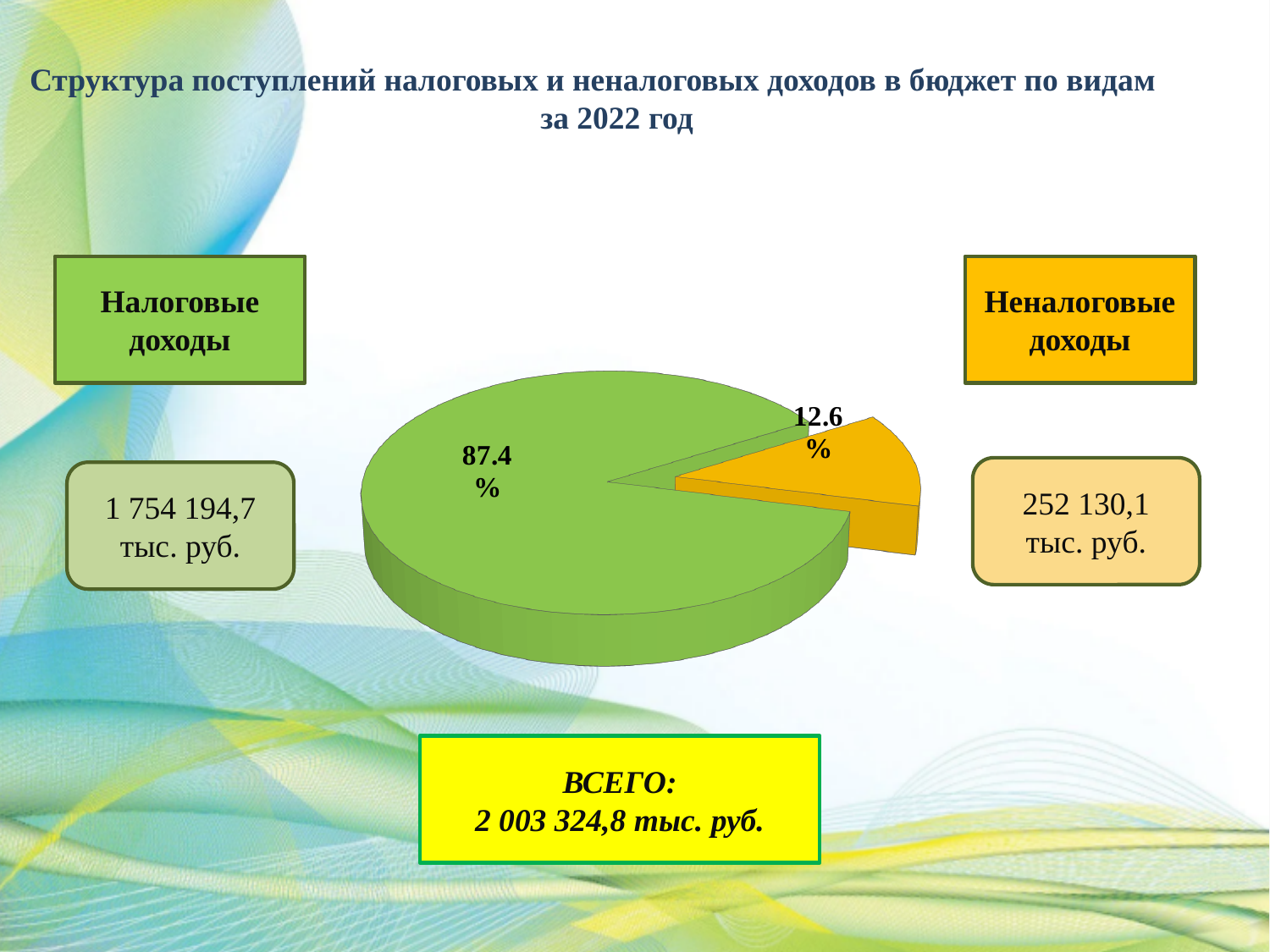
Which category has the largest slice of the pie? Налоговые доходы What is the difference in percentage points between the Налоговые доходы slice and the Неналоговые доходы slice? 74.8 Which category has the smallest slice of the pie? Неналоговые доходы How many slices does the pie chart have? 2 What colour is the slice for Неналоговые доходы? orange What is the amount shown for Неналоговые доходы? 252 130,1 тыс. руб. What is the total (ВСЕГО) shown on the slide? 2 003 324,8 тыс. руб. Which is larger, the share for Налоговые доходы or the share for Неналоговые доходы? Налоговые доходы What is the amount shown for Налоговые доходы? 1 754 194,7 тыс. руб. What kind of chart is shown on the slide? pie chart What share of the pie does Неналоговые доходы take? 12.6% What share of the pie does Налоговые доходы take? 87.4%